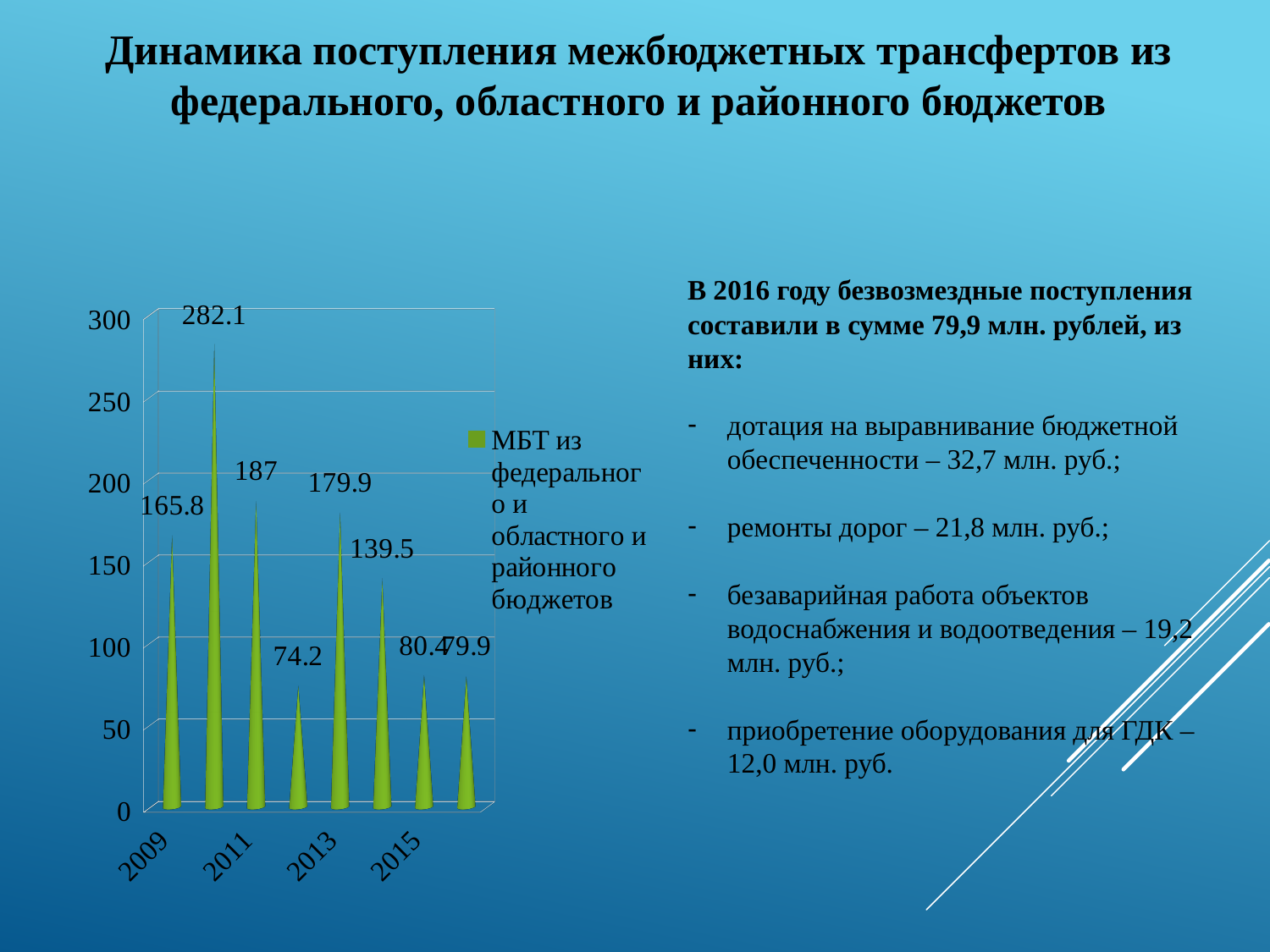
Is the value for 2015 greater or less than 100? less Which year has the larger value, 2013 or 2015? 2013 What is the value for 2015 in the chart? 80.4 What is the highest value shown in the chart? 282.1 What is the value for 2011 in the chart? 187 What kind of chart is shown on the slide? bar chart How many series does the legend list? 1 How many bars are plotted in the chart? 8 What is the value for 2009 in the chart? 165.8 What is the value for 2013 in the chart? 179.9 What is the lowest value shown in the chart? 74.2 What is the difference between the values for 2011 and 2009? 21.2